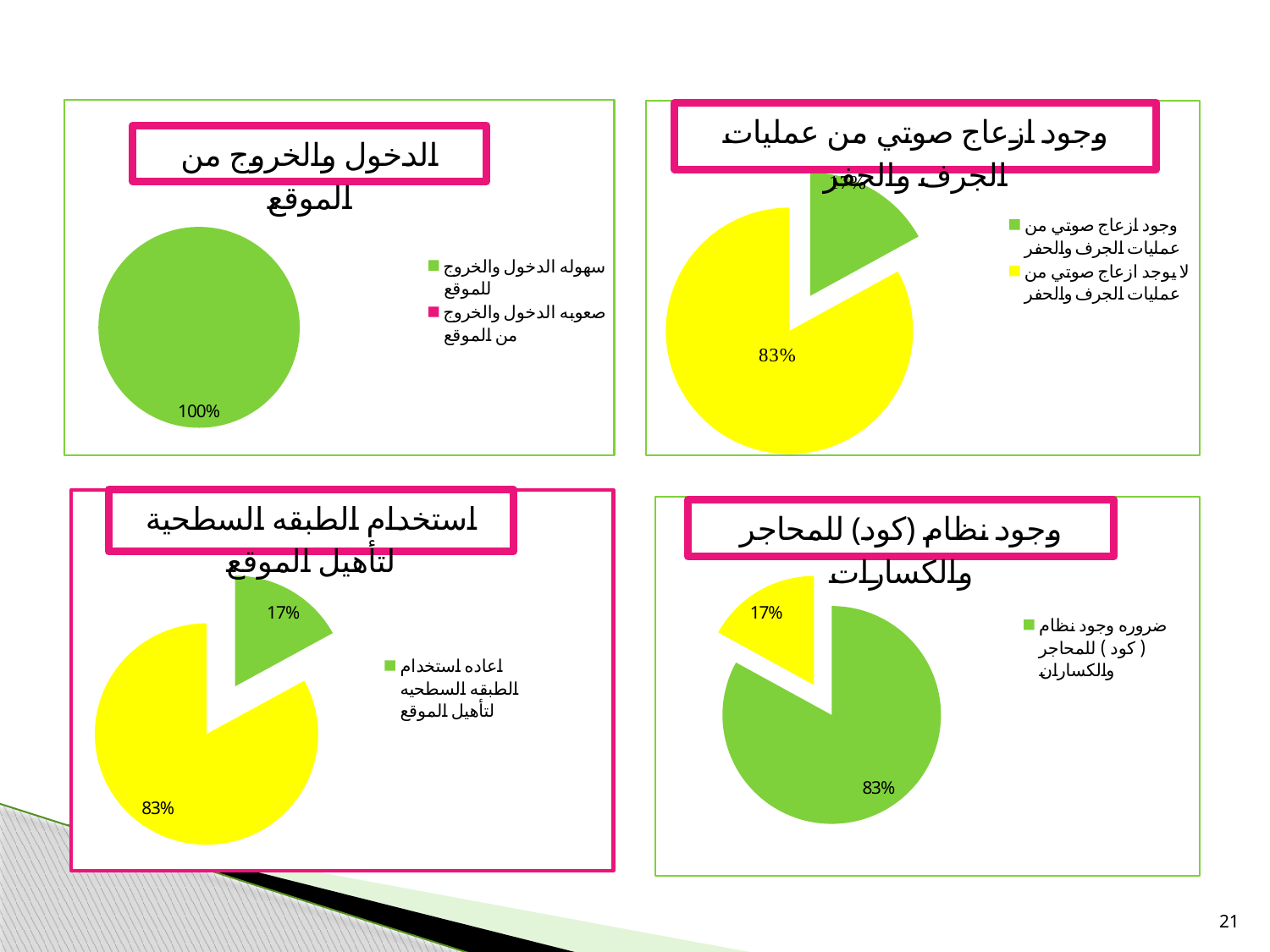
In the top-right chart ("وجود ازعاج صوتي من عمليات الجرف والحفر"), which slice is larger, the yellow one or the green one? yellow In the bottom-left chart ("استخدام الطبقه السطحية لتأهيل الموقع"), what percentage is shown on the yellow slice? 83% In the bottom-left chart, what is the difference between the yellow slice and the green slice? 66% In the bottom-left chart ("استخدام الطبقه السطحية لتأهيل الموقع"), what percentage is shown on the green slice? 17% How many entries does the legend of the top-left chart ("الدخول والخروج من الموقع") list? 2 What type of chart is used in the top-left chart titled "الدخول والخروج من الموقع"? pie chart How many pie charts are shown on the slide? 4 In the top-right chart, which legend entry corresponds to the yellow slice? لا يوجد ازعاج صوتي من عمليات الجرف والحفر In the top-right chart ("وجود ازعاج صوتي من عمليات الجرف والحفر"), what percentage is printed on the yellow slice? 83% In the bottom-right chart ("وجود نظام (كود) للمحاجر والكسارات"), what percentage is shown on the green slice? 83% In the top-left chart ("الدخول والخروج من الموقع"), what percentage is shown on the green slice? 100% In the bottom-right chart ("وجود نظام (كود) للمحاجر والكسارات"), what percentage is shown on the yellow slice? 17%